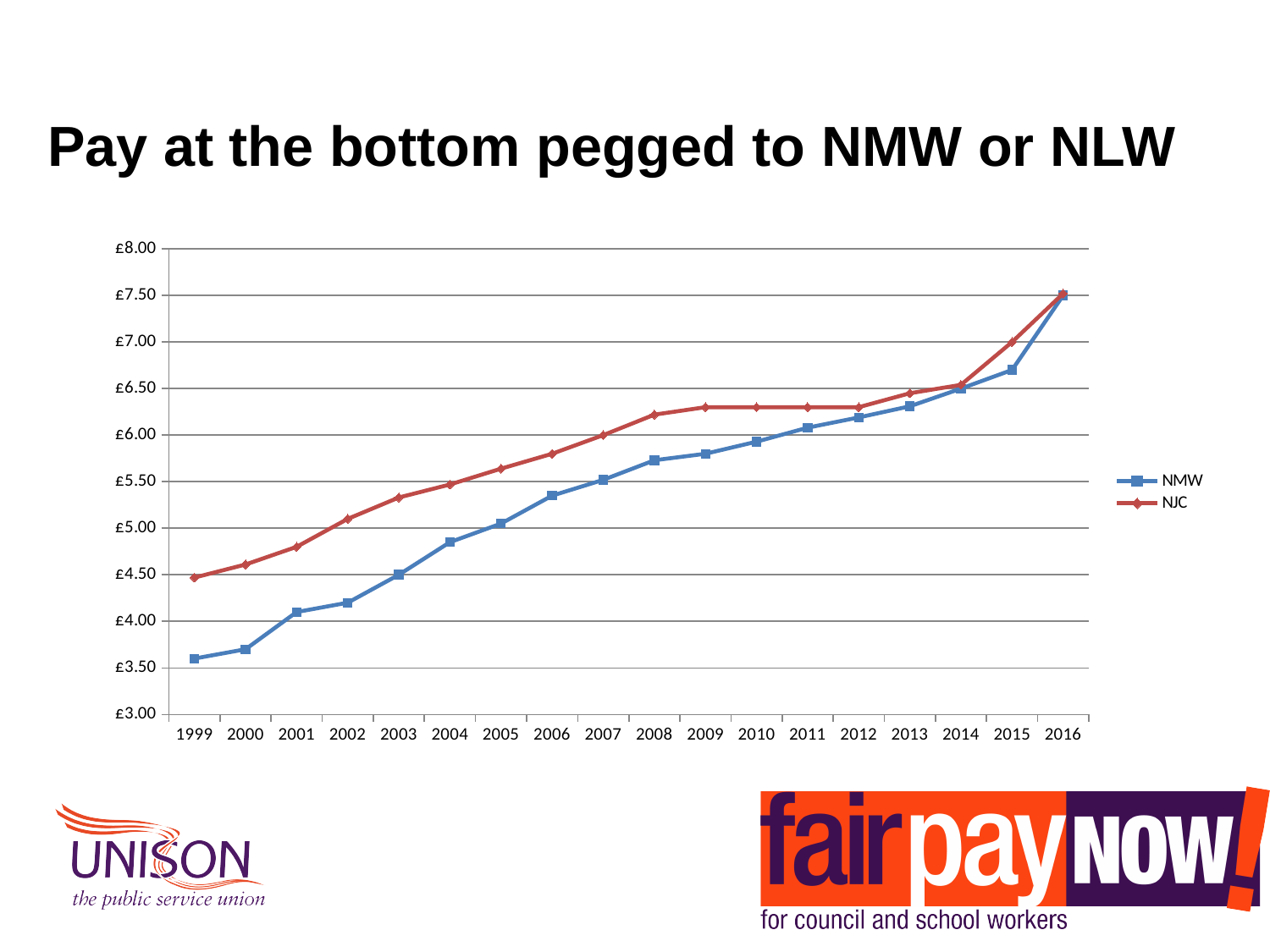
Is the NMW value for 2015 greater or less than £6.50? greater What kind of chart is shown on the slide? line chart In which year is the NMW value highest? 2016 What is the title of the slide containing the chart? Pay at the bottom pegged to NMW or NLW In which year is the NJC value lowest? 1999 How many series does the legend list? 2 In 2005, which series has the larger value, NMW or NJC? NJC Is the NJC value for 2012 greater or less than £6.50? less How many years are plotted along the x axis? 18 Is the NJC value for 2008 greater or less than £6.00? greater Do the NMW values rise or fall from 1999 to 2016? rise